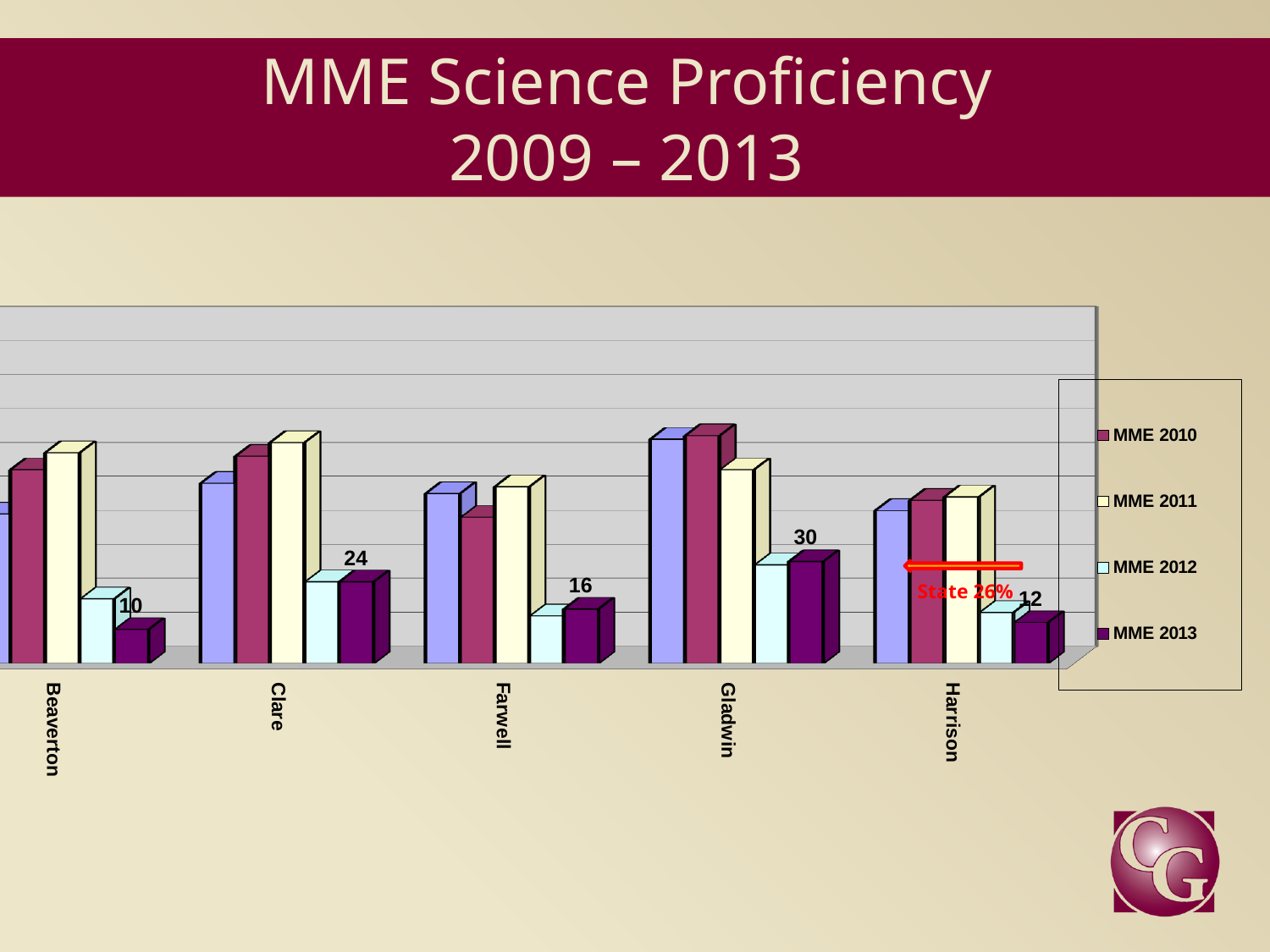
Which has the larger MME 2013 value, Farwell or Harrison? Farwell What kind of chart is shown on the slide? bar chart Which district has the lowest MME 2013 value? Beaverton What state value is annotated in red on the chart? State 26% Which district has the highest MME 2013 value? Gladwin What is the difference between the MME 2013 values for Gladwin and Clare? 6 What is the MME 2013 value for Clare? 24 What is the MME 2013 value for Beaverton? 10 How many districts are shown on the x axis of the chart? 5 What is the MME 2013 value for Farwell? 16 What is the MME 2013 value for Gladwin? 30 What is the MME 2013 value for Harrison? 12